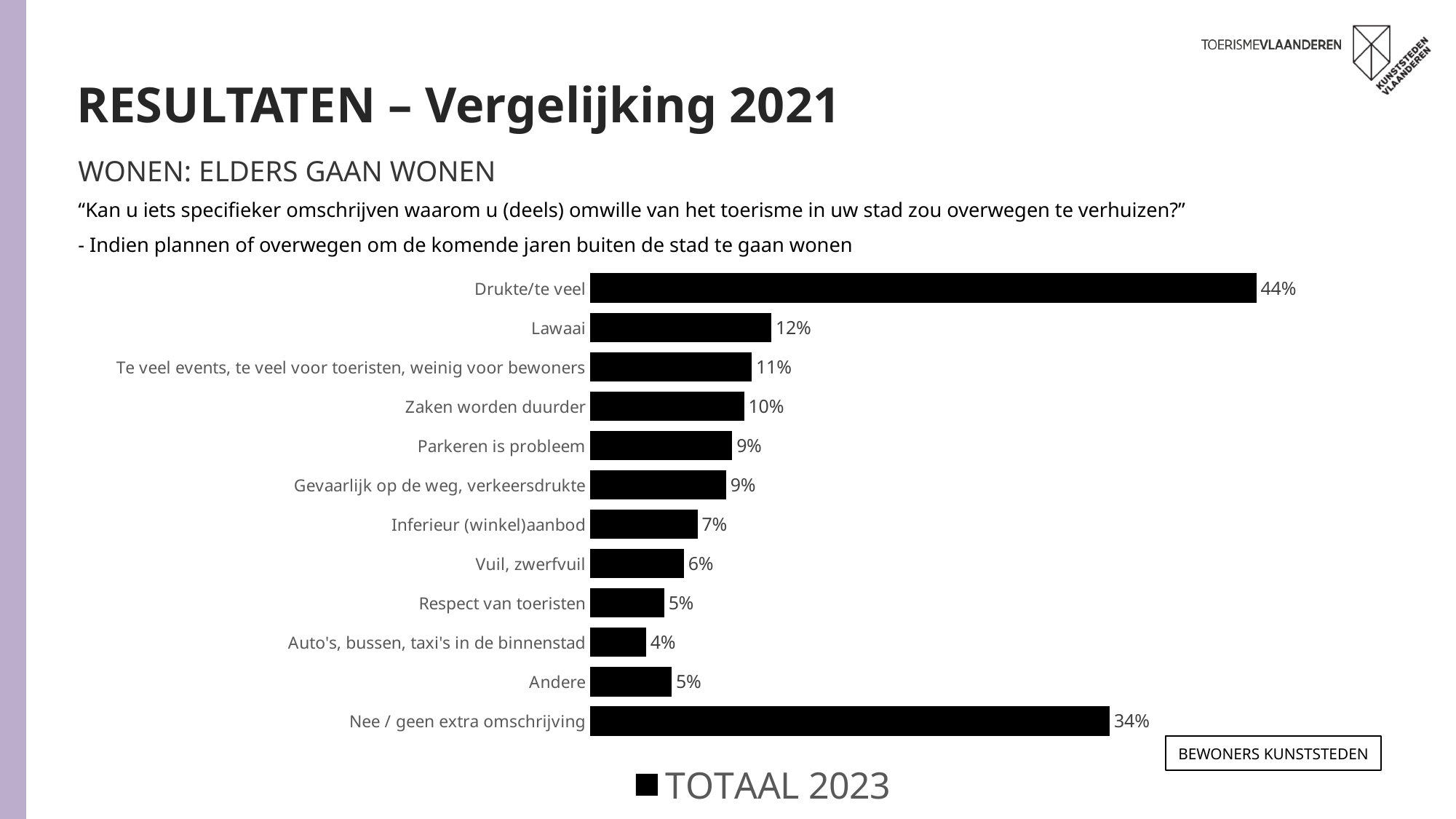
How many series does the legend list? 1 What is the value for "Drukte/te veel"? 44% What is the value for "Nee / geen extra omschrijving"? 34% How many categories are shown in the chart? 12 What is the difference between the values for "Drukte/te veel" and "Nee / geen extra omschrijving"? 10% Which is larger, the value for "Lawaai" or the value for "Zaken worden duurder"? Lawaai What is the difference between the values for "Inferieur (winkel)aanbod" and "Vuil, zwerfvuil"? 1% Which category has the highest value? Drukte/te veel What is the value for "Auto's, bussen, taxi's in de binnenstad"? 4% What kind of chart is shown on the slide? Bar chart What is the value for "Lawaai"? 12% Which category has the lowest value? Auto's, bussen, taxi's in de binnenstad